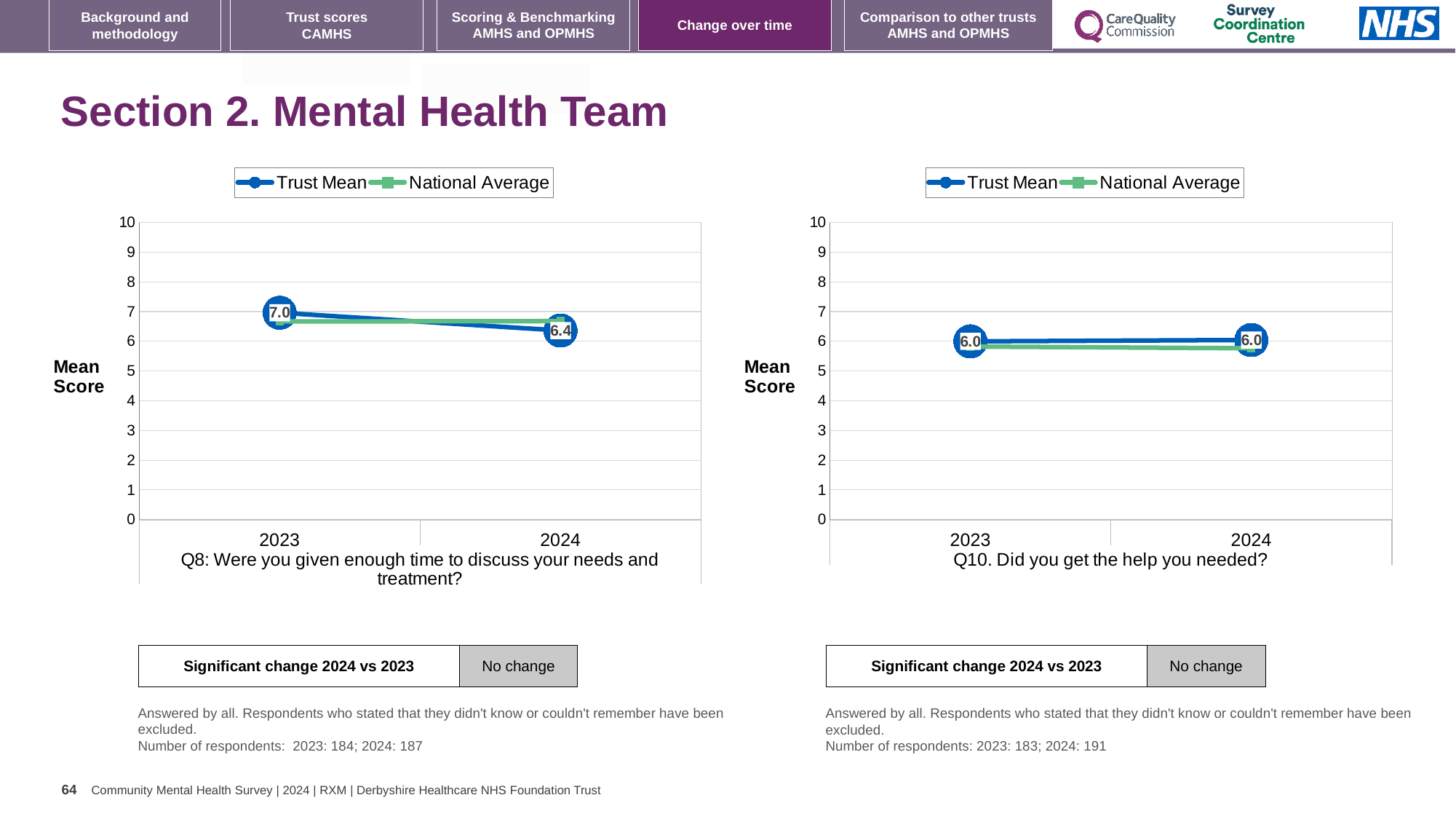
In the left chart (Q8), what is the Trust Mean value for 2023? 7.0 In the left chart (Q8), is the National Average value for 2023 greater or less than 6? greater What type of chart is used on the left (Q8)? line chart In the left chart (Q8), does the Trust Mean rise or fall from 2023 to 2024? fall In the right chart (Q10), what is the Trust Mean value for 2024? 6.0 In the right chart (Q10), is the National Average value for 2024 greater or less than 5? greater How many series does the legend of the right chart (Q10) list? 2 How many years are plotted on the x axis of the left chart (Q8)? 2 In the left chart (Q8), what is the Trust Mean value for 2024? 6.4 In the right chart (Q10), what is the Trust Mean value for 2023? 6.0 In the left chart (Q8), which year has the higher Trust Mean, 2023 or 2024? 2023 In the left chart (Q8), by how much did the Trust Mean fall from 2023 to 2024? 0.6